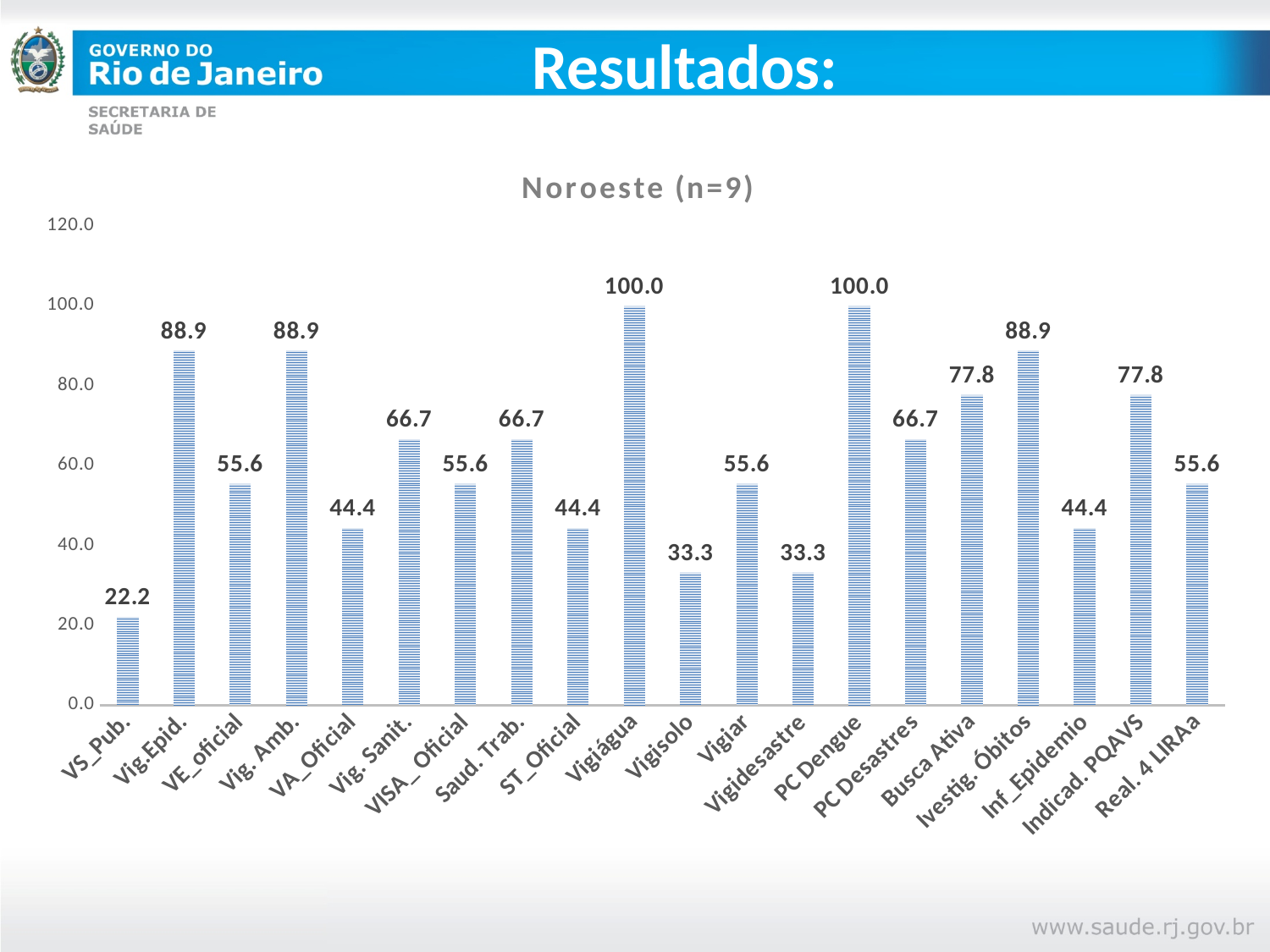
What is the title of the chart? Noroeste (n=9) What is the value for VS_Pub.? 22.2 How many categories are shown on the x axis? 20 What is the difference between the values for Vig.Epid. and VE_oficial? 33.3 What is the value for Busca Ativa? 77.8 Which category has the lowest value? VS_Pub. What is the value for Vigiágua? 100.0 What kind of chart is shown on the slide? Bar chart What is the highest value shown in the chart? 100.0 What is the difference between the values for PC Dengue and PC Desastres? 33.3 Which is larger, the value for Vigiar or the value for Vigidesastre? Vigiar What is the value for Vigisolo? 33.3